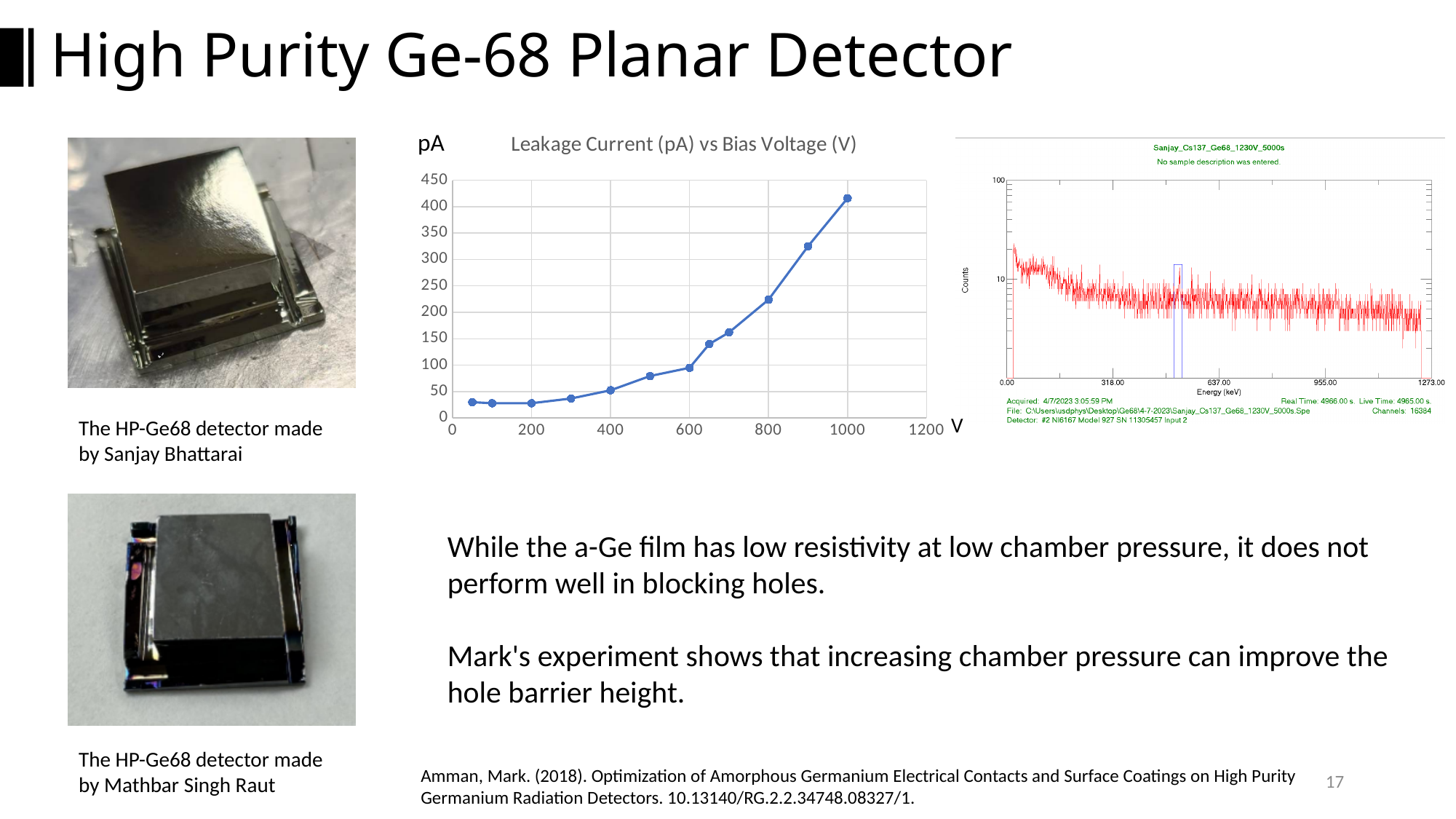
In the 'Leakage Current (pA) vs Bias Voltage (V)' chart, is the leakage current at 1000 V greater or less than 350? greater In the 'Leakage Current (pA) vs Bias Voltage (V)' chart, is the leakage current at 900 V greater or less than 300? greater What is the title of the chart in the middle of the slide? Leakage Current (pA) vs Bias Voltage (V) How many data points are plotted in the 'Leakage Current (pA) vs Bias Voltage (V)' chart? 12 In the 'Leakage Current (pA) vs Bias Voltage (V)' chart, at which bias voltage is the leakage current highest? 1000 In the 'Leakage Current (pA) vs Bias Voltage (V)' chart, is the leakage current at 200 V greater or less than 50? less In the 'Leakage Current (pA) vs Bias Voltage (V)' chart, do the values rise or fall as bias voltage increases? rise In the 'Leakage Current (pA) vs Bias Voltage (V)' chart, what is the maximum value shown on the vertical axis? 450 What kind of chart is the 'Leakage Current (pA) vs Bias Voltage (V)' chart? line chart In the 'Leakage Current (pA) vs Bias Voltage (V)' chart, which is larger, the leakage current at 800 V or at 600 V? 800 V